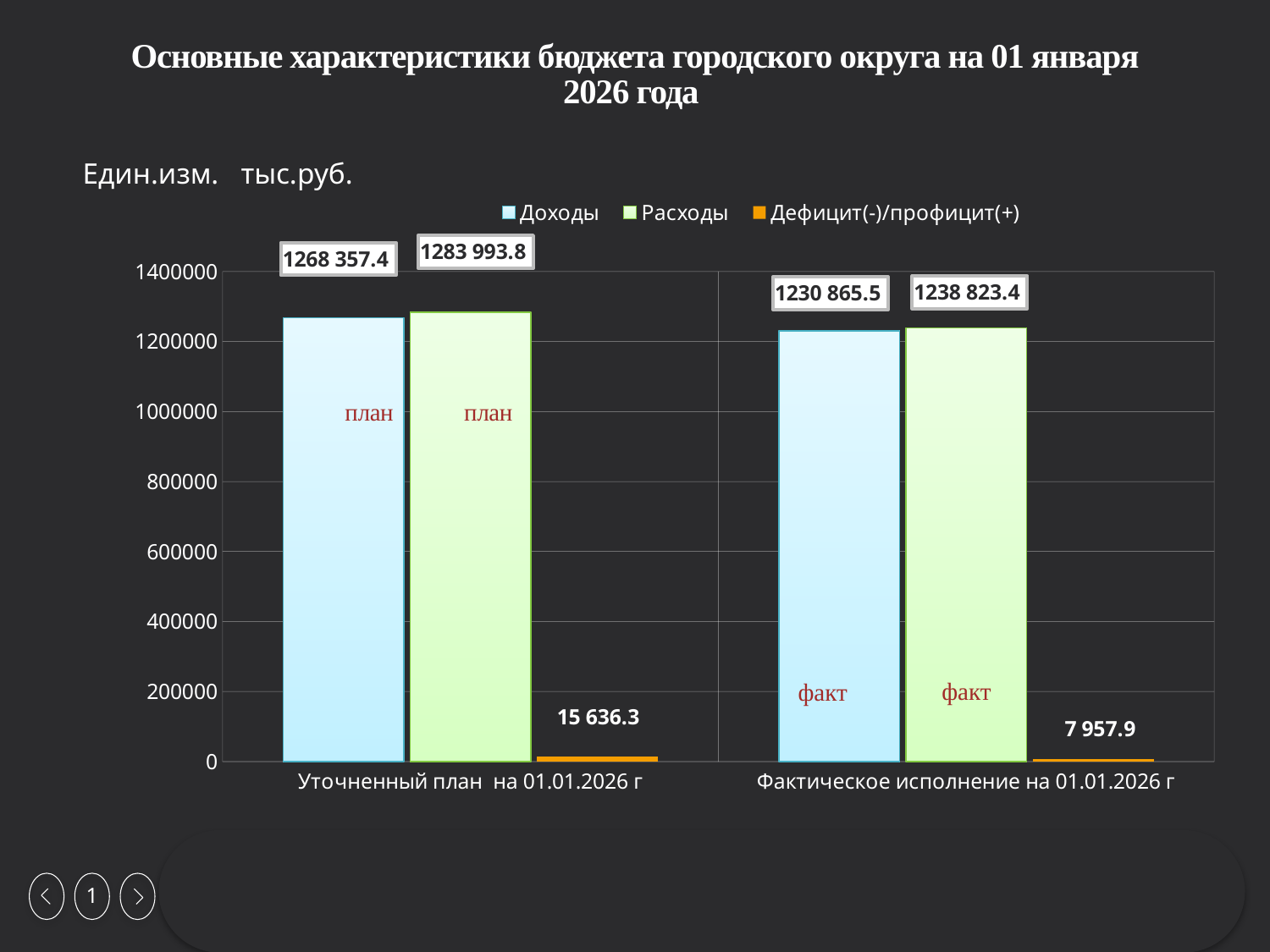
What is the value of Расходы for Фактическое исполнение на 01.01.2026 г? 1238 823.4 What is the value of Дефицит(-)/профицит(+) for Уточненный план на 01.01.2026 г? 15 636.3 What kind of chart is shown on the slide? Bar chart How many series does the legend list? 3 Which is larger: Дефицит(-)/профицит(+) for Уточненный план на 01.01.2026 г or for Фактическое исполнение на 01.01.2026 г? Уточненный план на 01.01.2026 г How many categories are shown on the x axis? 2 Which series has the highest value in the Уточненный план на 01.01.2026 г category? Расходы What is the value of Доходы for Фактическое исполнение на 01.01.2026 г? 1230 865.5 What is the value of Доходы for Уточненный план на 01.01.2026 г? 1268 357.4 What is the difference between Доходы for Уточненный план на 01.01.2026 г and Доходы for Фактическое исполнение на 01.01.2026 г? 37 491.9 What is the difference between Расходы and Доходы for Фактическое исполнение на 01.01.2026 г? 7 957.9 Which series has the lowest value in the Фактическое исполнение на 01.01.2026 г category? Дефицит(-)/профицит(+)